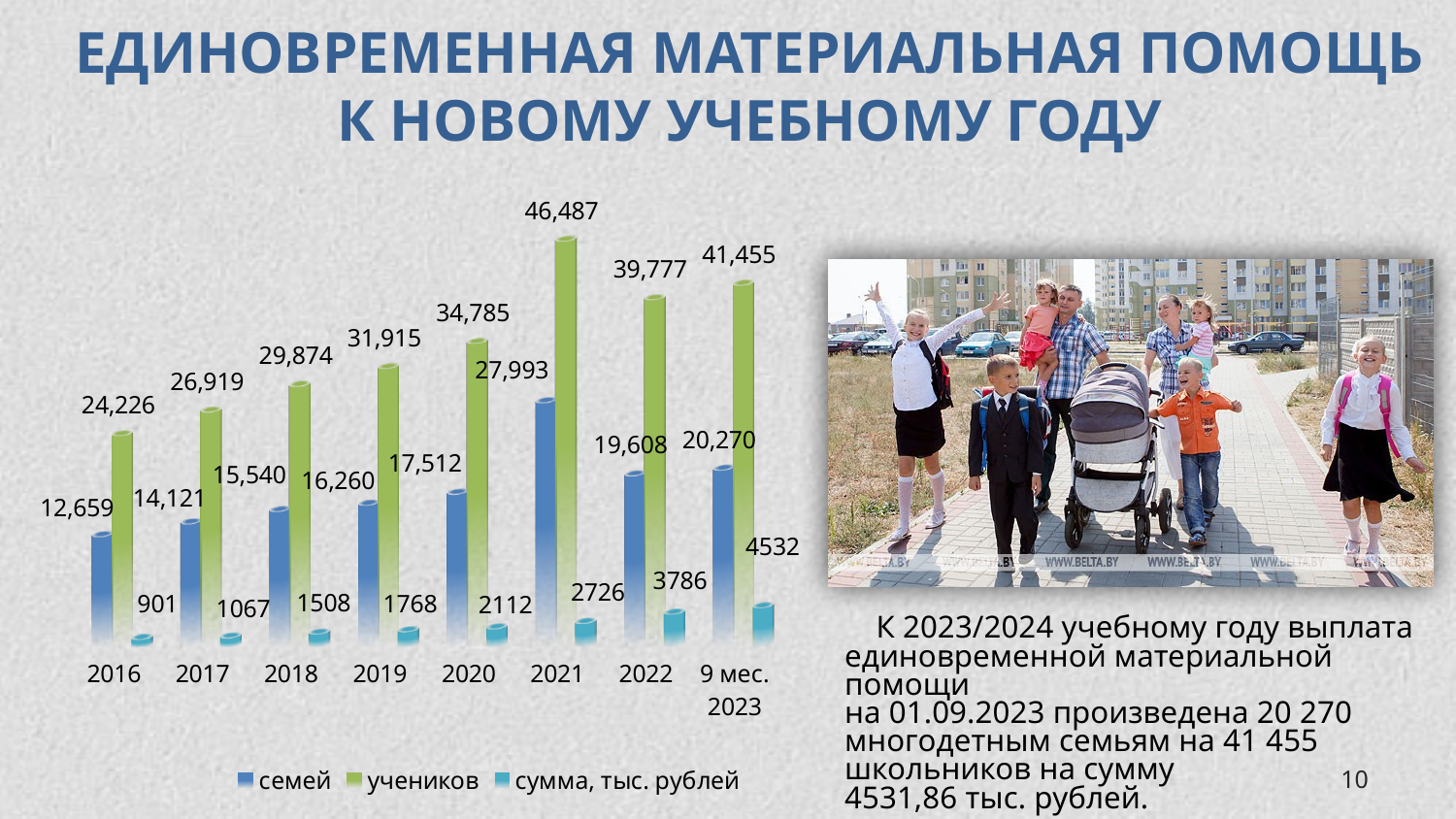
Does the 'сумма, тыс. рублей' series rise or fall from 2016 to 9 мес. 2023? rise How many categories are shown on the x axis of the chart? 8 How many series does the chart legend list? 3 In which year is the 'учеников' value highest? 2021 In which category is the 'сумма, тыс. рублей' value lowest? 2016 What is the difference between the 'учеников' values for 2021 and 2022? 6,710 What is the value of the 'учеников' series for 2021? 46,487 What is the value of the 'семей' series for 2016? 12,659 What type of chart is shown on the slide? bar chart Which series is shown in green in the chart? учеников Which is larger: the 'семей' value for 2022 or for 9 мес. 2023? 9 мес. 2023 What is the value of the 'сумма, тыс. рублей' series for 2022? 3786